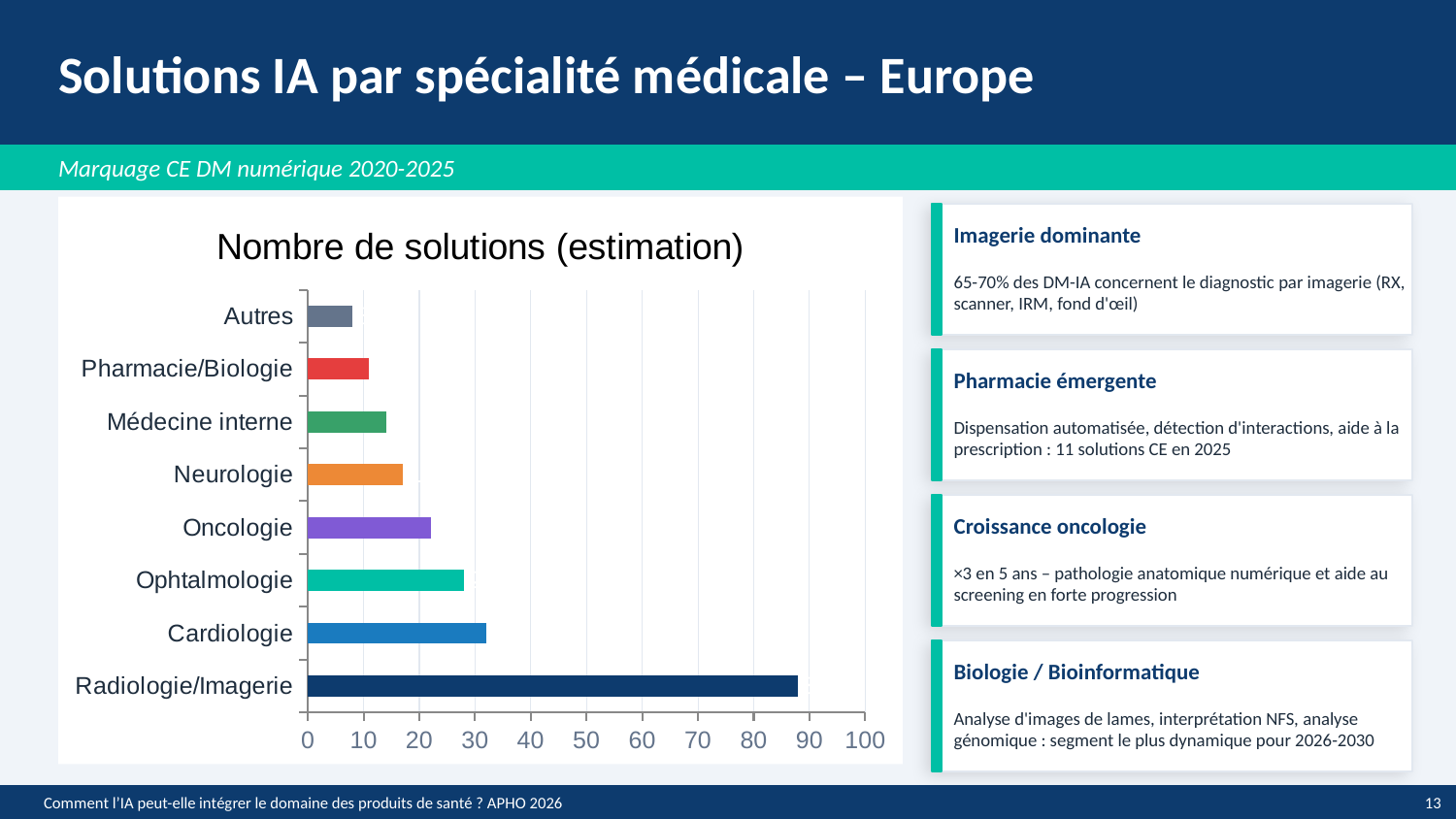
Which has a larger value, Ophtalmologie or Médecine interne? Ophtalmologie Which has a larger value, Cardiologie or Oncologie? Cardiologie Is the value for Neurologie greater or less than 20? less What kind of chart is shown on the slide? bar chart How many categories are plotted in the chart? 8 Which category has the lowest value in the chart? Autres Which category has the highest value in the chart? Radiologie/Imagerie What is the title of the chart? Nombre de solutions (estimation) Is the value for Oncologie greater or less than 30? less Is the value for Autres greater or less than 10? less